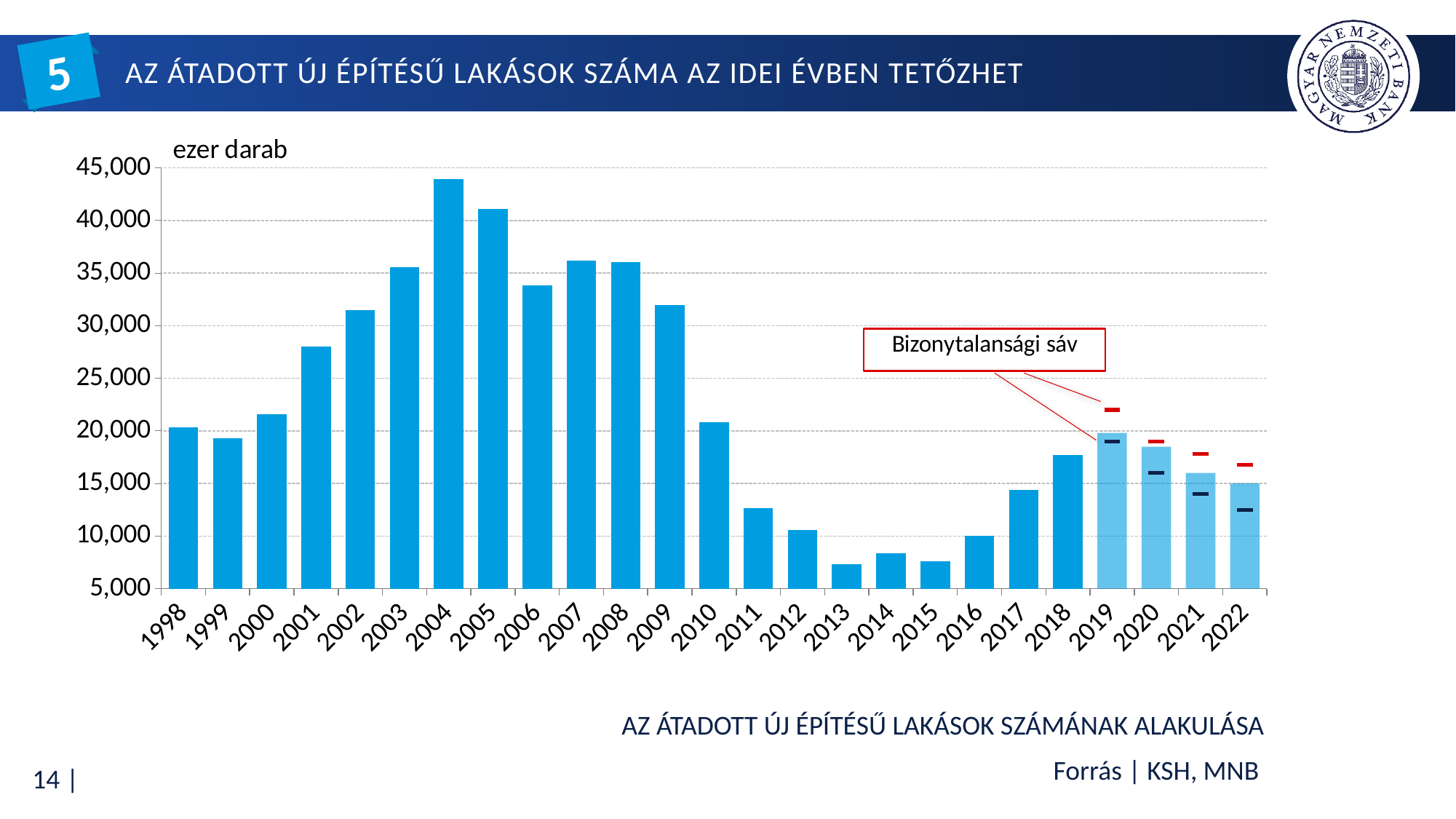
Which is larger, the value for 2010 or the value for 2011? 2010 Is the value for 2013 greater or less than 10,000? less How many years are shown on the x axis of the chart? 25 What kind of chart is shown on the slide? bar chart Is the value for 2011 greater or less than 15,000? less Is the value for 2004 greater or less than 40,000? greater Do the values rise or fall from 2004 to 2013? fall Which year has the highest bar in the chart? 2004 Which is larger, the value for 2004 or the value for 2005? 2004 What unit label is shown above the vertical axis of the chart? ezer darab